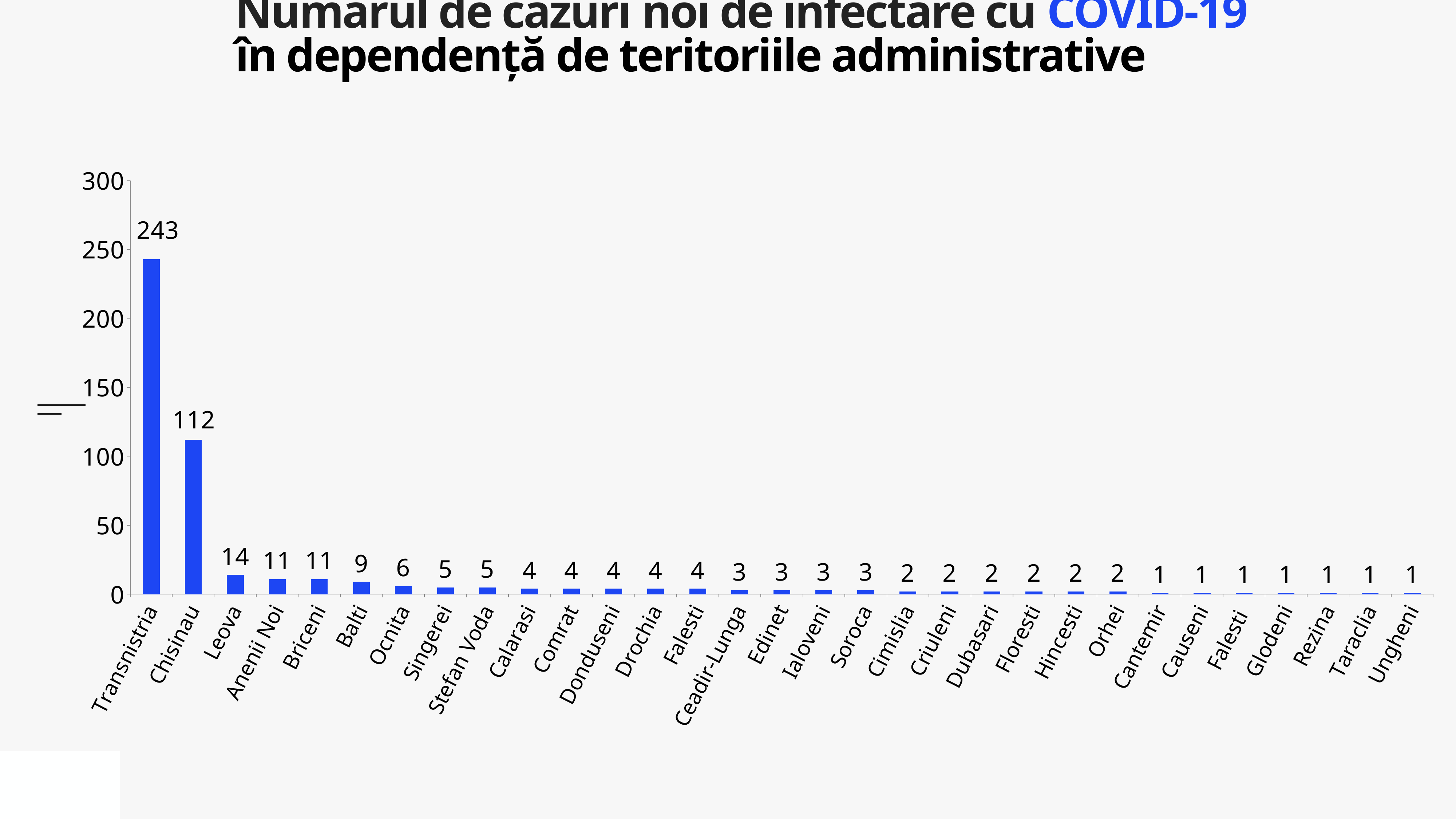
How many categories are shown on the x axis? 31 Is the value for Chisinau greater or less than 100? greater What kind of chart is shown on the slide? bar chart Which is larger, the value for Leova or the value for Briceni? Leova What is the value for Leova? 14 What is the value for Chisinau? 112 What is the value for Transnistria? 243 What is the value for Ocnita? 6 Which category has the highest value? Transnistria What is the difference between the values for Transnistria and Chisinau? 131 Do the values rise or fall from left to right along the x axis? fall What is the value for Balti? 9